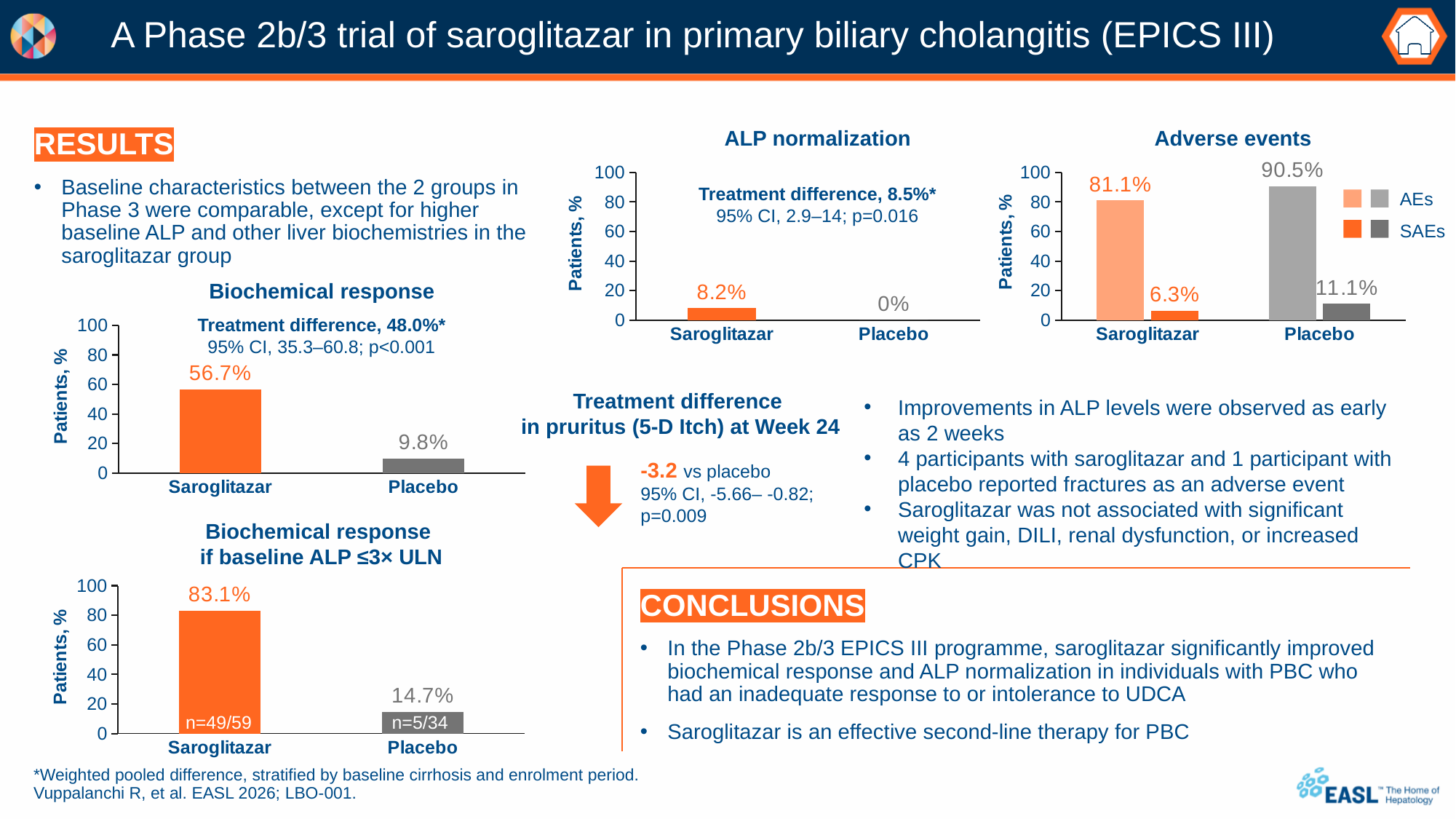
In the 'Adverse events' chart, what is the SAEs value for Saroglitazar? 6.3% What kind of chart is the 'ALP normalization' chart? Bar chart In the 'ALP normalization' chart, which group has the higher value? Saroglitazar In the 'Adverse events' chart, how many series does the legend list? 2 In the 'Biochemical response' chart, is the value for Saroglitazar greater or less than 40? greater In the 'Biochemical response' chart, what is the value for Saroglitazar? 56.7% In the 'Biochemical response if baseline ALP ≤3× ULN' chart, what is the value for Saroglitazar? 83.1% In the 'Adverse events' chart, what is the AEs value for Placebo? 90.5% In the 'Biochemical response if baseline ALP ≤3× ULN' chart, what is the difference between the Saroglitazar and Placebo values? 68.4% In the 'Adverse events' chart, which group has the higher SAEs value? Placebo In the 'ALP normalization' chart, what is the value for Placebo? 0% In the 'Biochemical response' chart, what is the value for Placebo? 9.8%